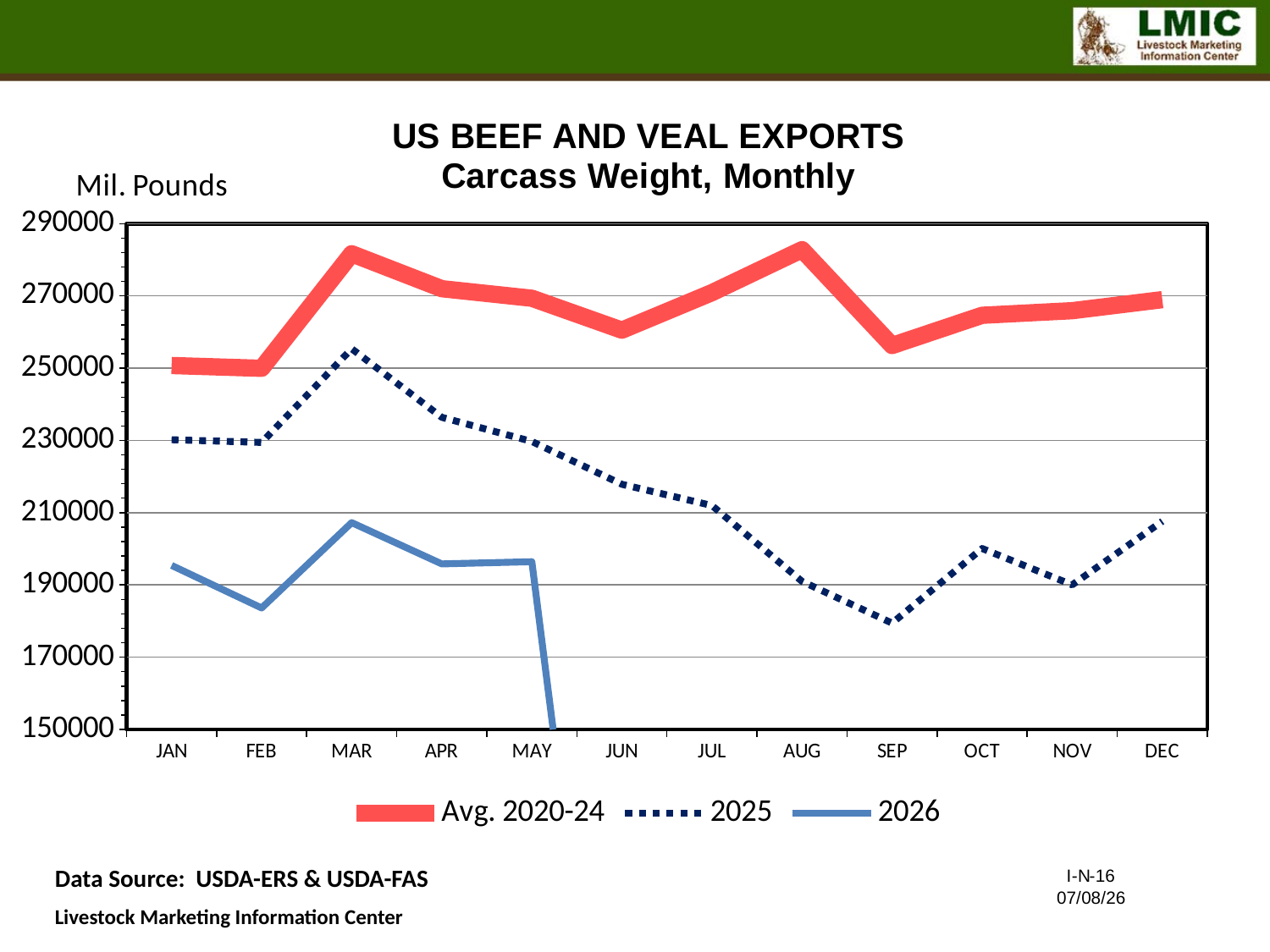
How many series does the legend list? 3 Is the value for Avg. 2020-24 in AUG greater or less than 270000? greater How many months are shown on the x axis? 12 Is the value for 2025 in MAR greater or less than 250000? greater What type of chart is shown on the slide? line chart Which month has the highest value for the 2026 series? MAR In MAR, which series has the larger value, 2025 or 2026? 2025 Which month has the lowest value for the 2025 series? SEP Which month has the highest value for the 2025 series? MAR Is the value for 2025 in SEP greater or less than 190000? less Does the 2025 series rise or fall from MAR to SEP? fall